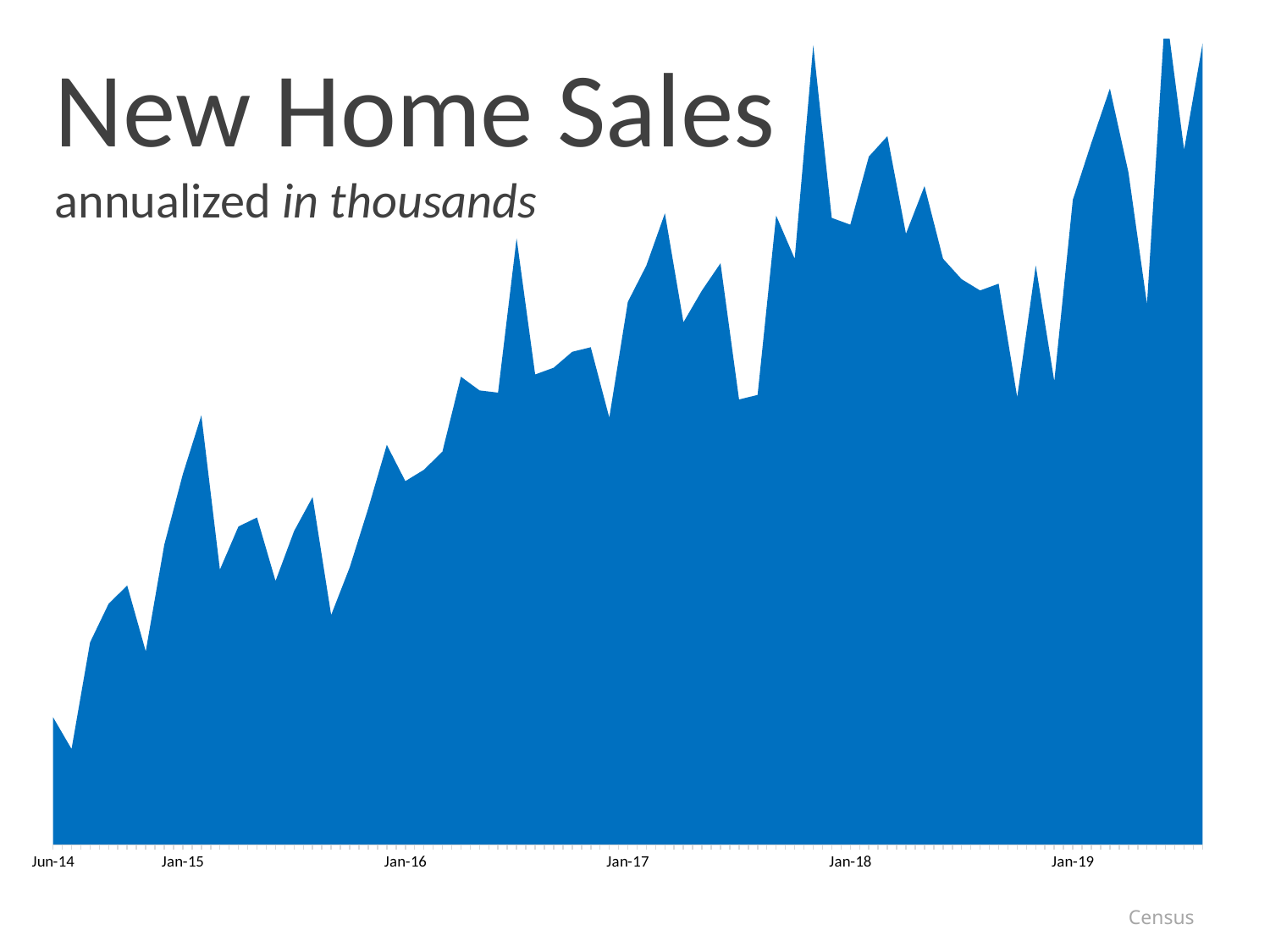
How many date labels are shown on the x axis? 6 In what units are the values plotted, according to the subtitle? annualized in thousands What kind of chart is shown on the slide? Area chart In which year does the chart reach its lowest point? 2014 What is the first date label on the x axis? Jun-14 Which is higher, new home sales around Jan-15 or around Jan-19? Jan-19 Which is higher, new home sales around Jan-16 or around Jan-17? Jan-17 Do new home sales generally rise or fall from Jun-14 to the end of the chart? Rise What is the title of the chart? New Home Sales In which year does the chart reach its highest point? 2019 What is the last date label on the x axis? Jan-19 Which is higher, new home sales around Jun-14 or around Jan-18? Jan-18